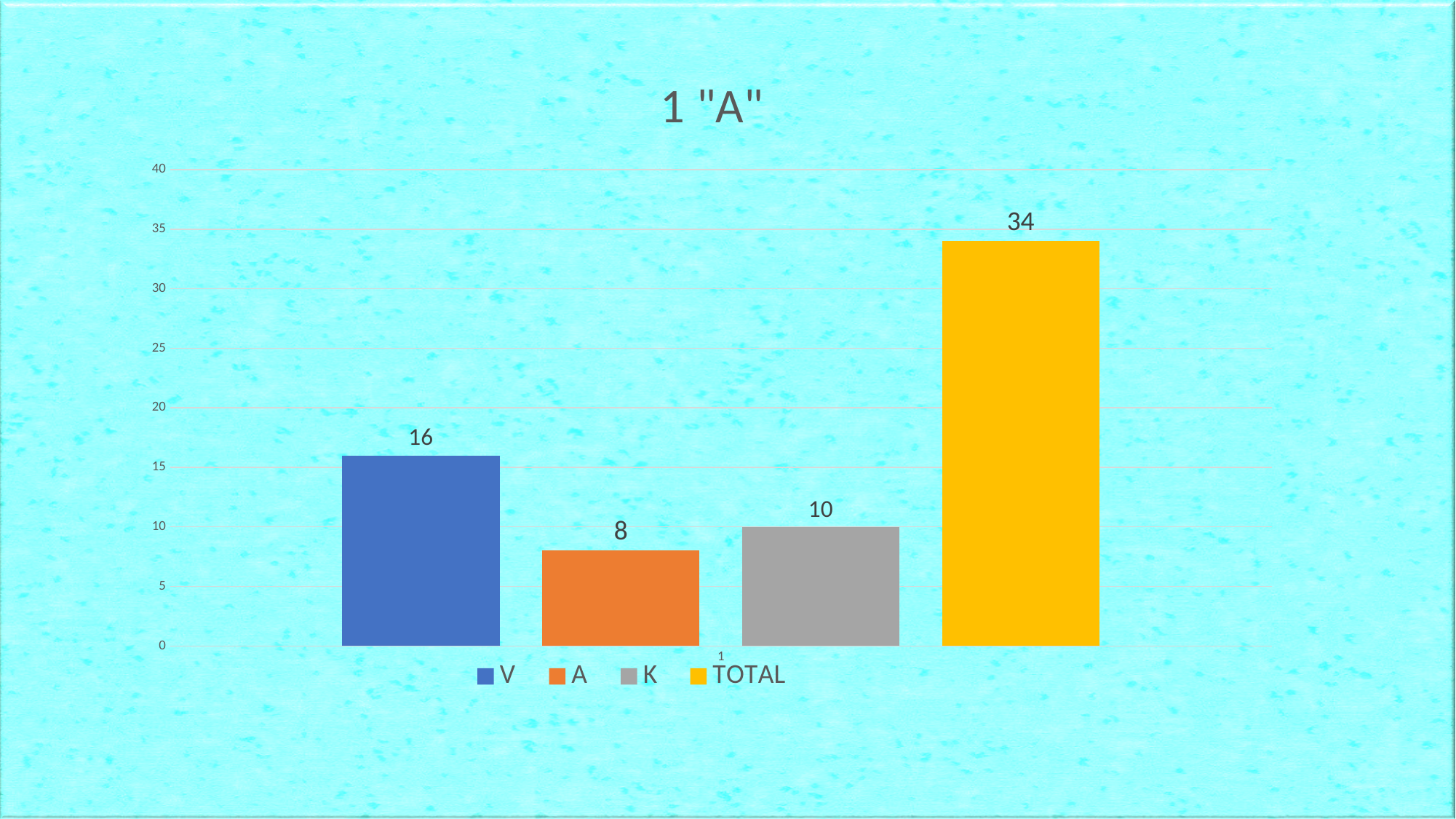
How many series does the legend list? 4 What is the value for TOTAL? 34 What is the difference between the values for TOTAL and K? 24 What kind of chart is shown on the slide? bar chart What is the value for K? 10 What is the value for V? 16 What is the value for A? 8 Which is larger, the value for V or the value for K? V Which series has the lowest value? A What is the difference between the values for V and A? 8 Which series has the highest value? TOTAL What is the title of the chart? 1 "A"